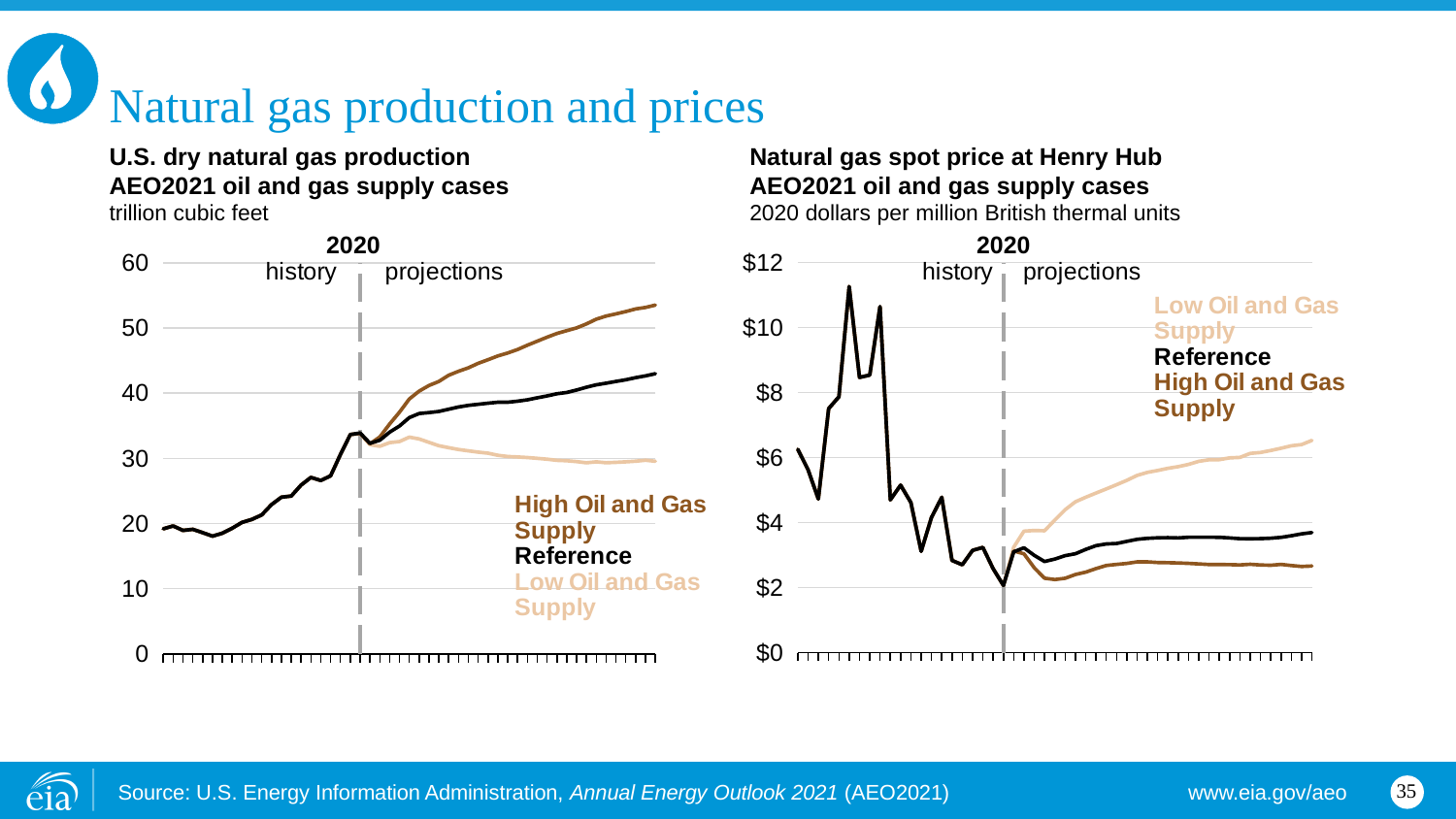
In the Natural gas spot price at Henry Hub chart, is the Low Oil and Gas Supply price at the end of the projections greater or less than $6? greater In the Natural gas spot price at Henry Hub chart, which case has the highest price at the end of the projection period? Low Oil and Gas Supply In the U.S. dry natural gas production chart, does the Low Oil and Gas Supply case rise or fall over the projection period? fall In the U.S. dry natural gas production chart, is the Reference case value at the end of the projections greater or less than 40? greater In the U.S. dry natural gas production chart, which case has the highest production at the end of the projection period? High Oil and Gas Supply What unit is used on the y axis of the U.S. dry natural gas production chart? trillion cubic feet In the U.S. dry natural gas production chart, is the High Oil and Gas Supply value at the end of the projections greater or less than 50? greater What kind of chart is the U.S. dry natural gas production chart on the left? line chart In the Natural gas spot price at Henry Hub chart, does the Low Oil and Gas Supply case rise or fall over the projection period? rise How many supply cases (series) are labelled on the Natural gas spot price at Henry Hub chart? 3